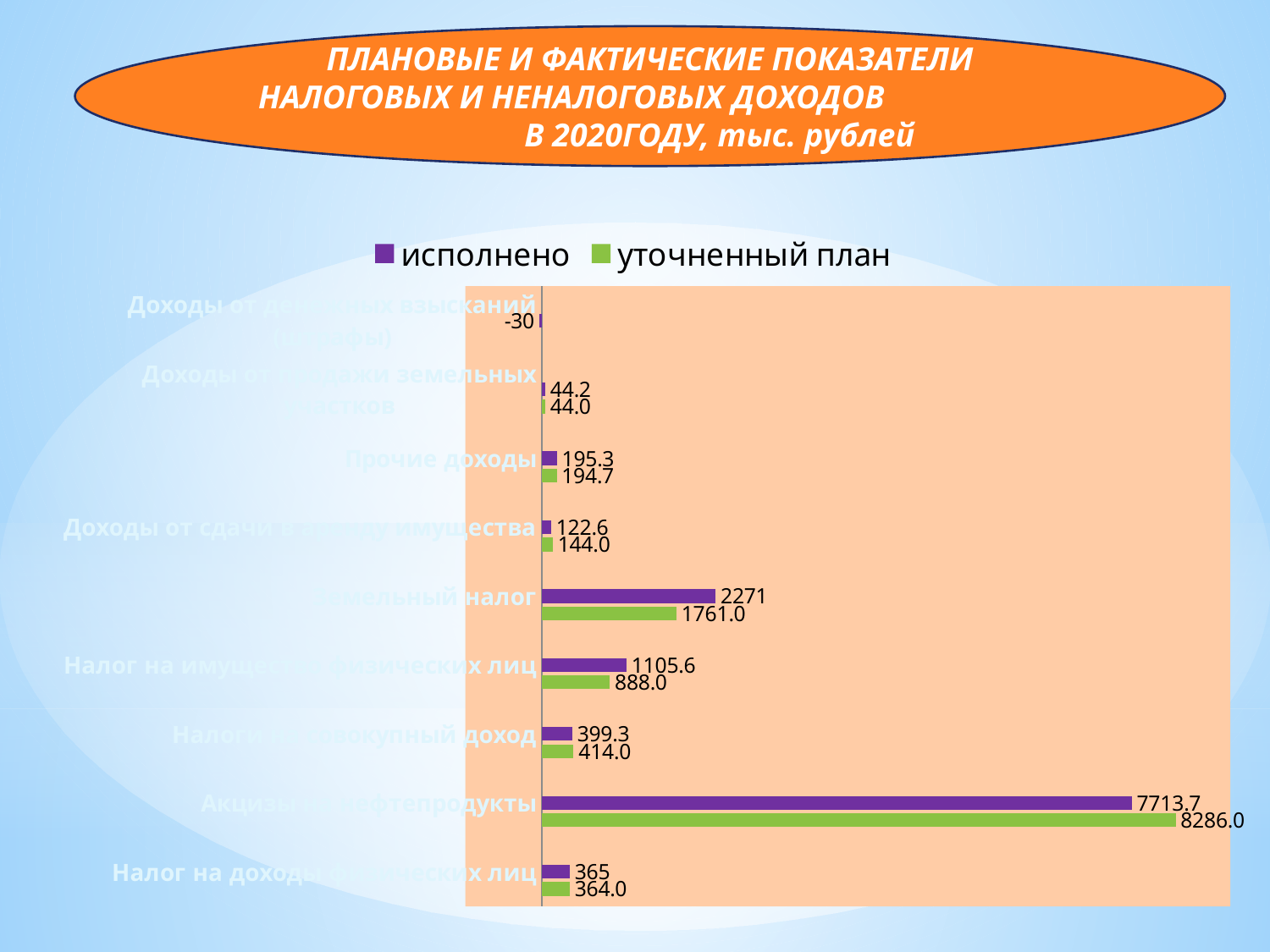
How many categories are plotted on the chart? 9 What is the уточненный план value for Земельный налог? 1761.0 Which category has the highest исполнено value? Акцизы на нефтепродукты What is the уточненный план value for Акцизы на нефтепродукты? 8286.0 How many series does the legend list? 2 What is the уточненный план value for Прочие доходы? 194.7 What is the исполнено value for Акцизы на нефтепродукты? 7713.7 What are the two series named in the legend? исполнено and уточненный план By how much does the уточненный план value exceed the исполнено value for Акцизы на нефтепродукты? 572.3 What is the исполнено value for Налог на доходы физических лиц? 365 What kind of chart is shown on the slide? bar chart For Земельный налог, which is larger: исполнено or уточненный план? исполнено